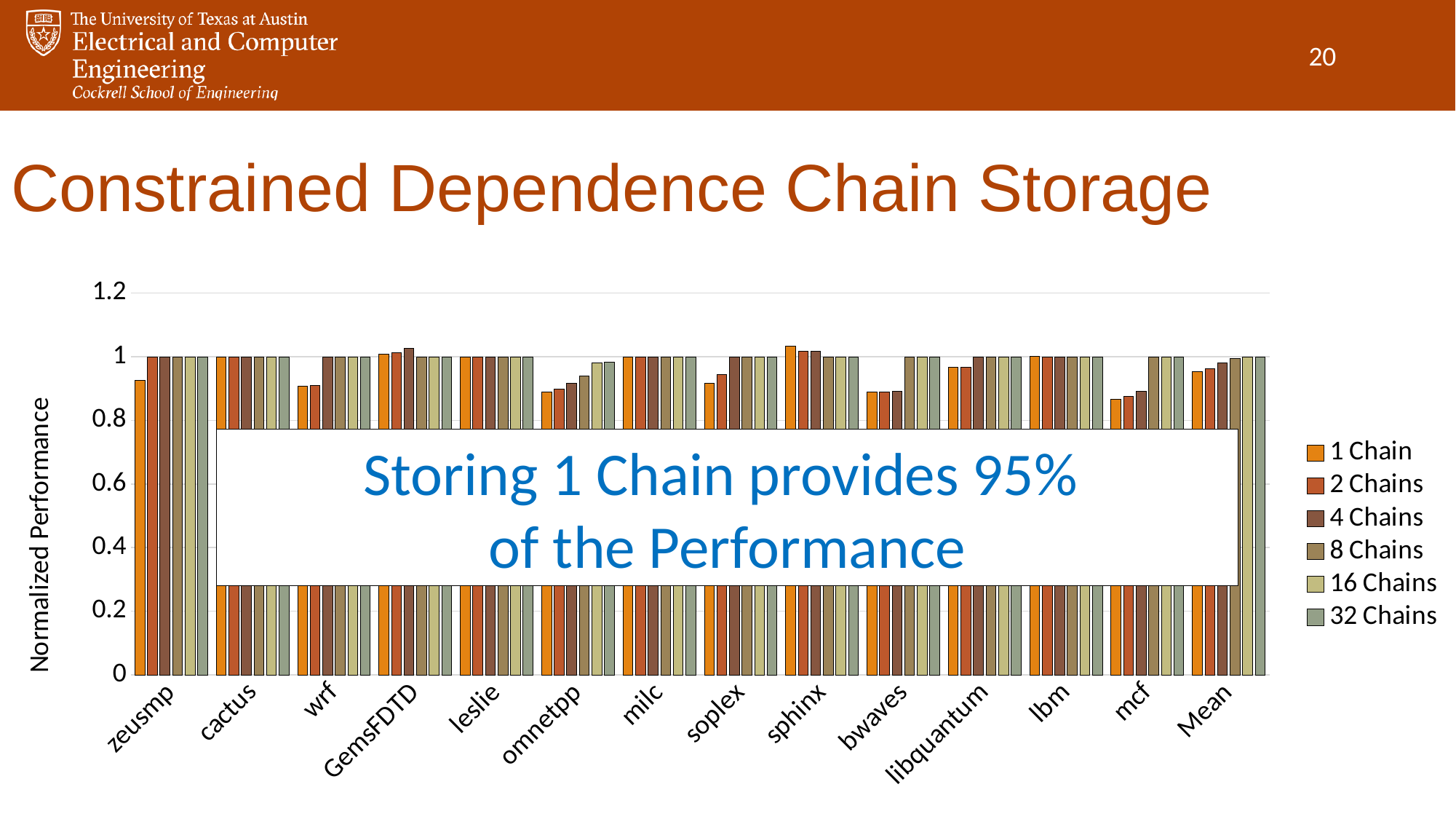
Is the 32 Chains value for omnetpp greater or less than 0.8? greater Is the 1 Chain value for bwaves greater or less than 0.8? greater Is the 1 Chain value for zeusmp greater or less than 1? less Which series is listed last in the legend? 32 Chains How many series does the legend list? 6 Which is larger, the 1 Chain value for omnetpp or the 32 Chains value for omnetpp? 32 Chains Which category has the highest 1 Chain value? sphinx Which is larger, the 1 Chain value for cactus or the 1 Chain value for mcf? cactus What is the label of the y axis? Normalized Performance What kind of chart is shown on the slide? bar chart How many categories are shown along the x axis? 14